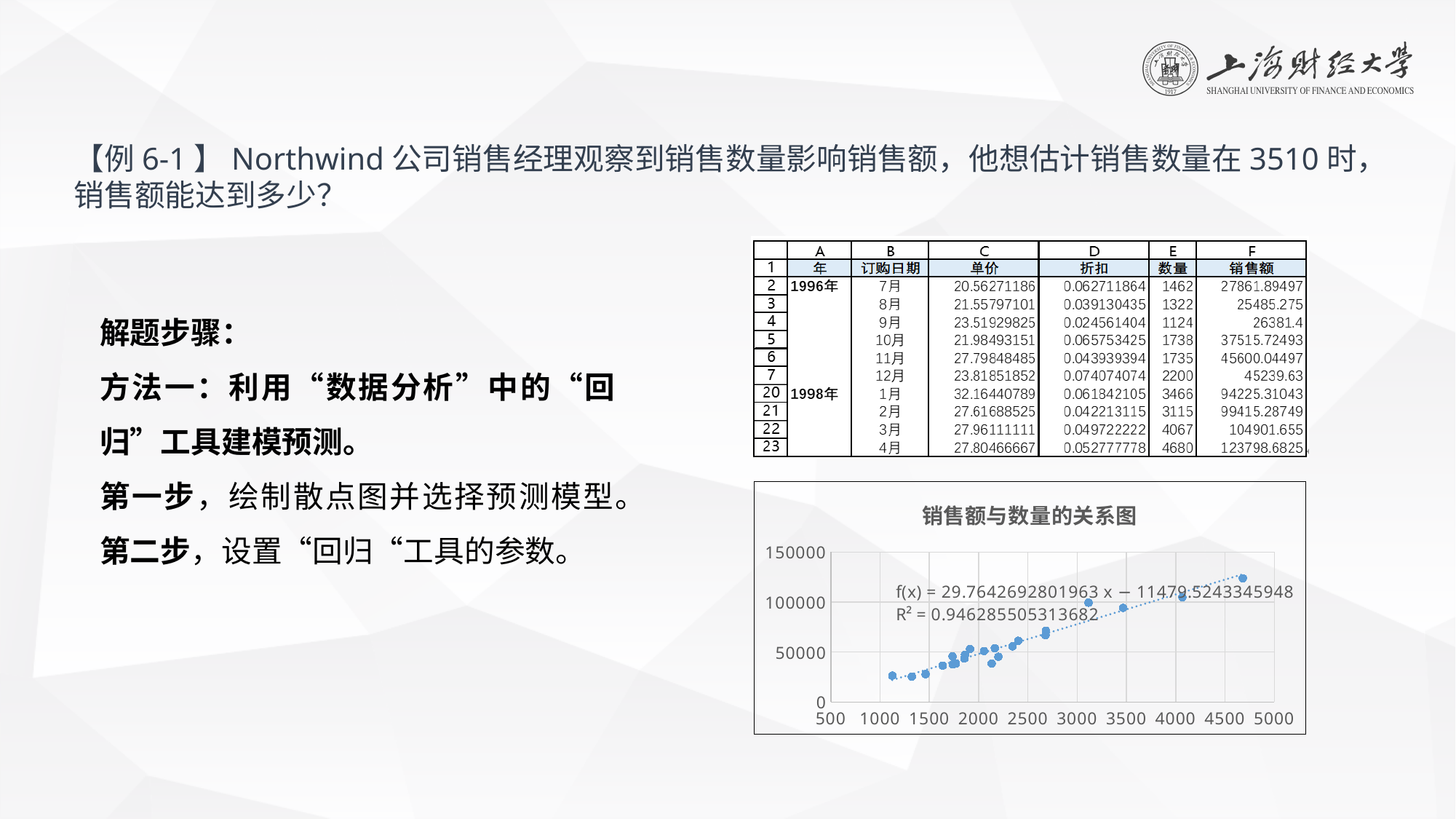
What is the highest tick value shown on the y axis of the chart? 150000 Do the plotted values generally rise or fall as the x axis increases? rise What R² value is printed on the chart? 0.946285505313682 What is the trendline equation printed on the chart? f(x) = 29.7642692801963 x − 11479.5243345948 Is the value for the point near x = 3500 greater or less than 50000? greater What is the title of the chart on the slide? 销售额与数量的关系图 Is the value for the rightmost point (near x = 4700) greater or less than 100000? greater What kind of chart is shown on the slide? scatter chart Is the value for the leftmost point (near x = 1100) greater or less than 50000? less